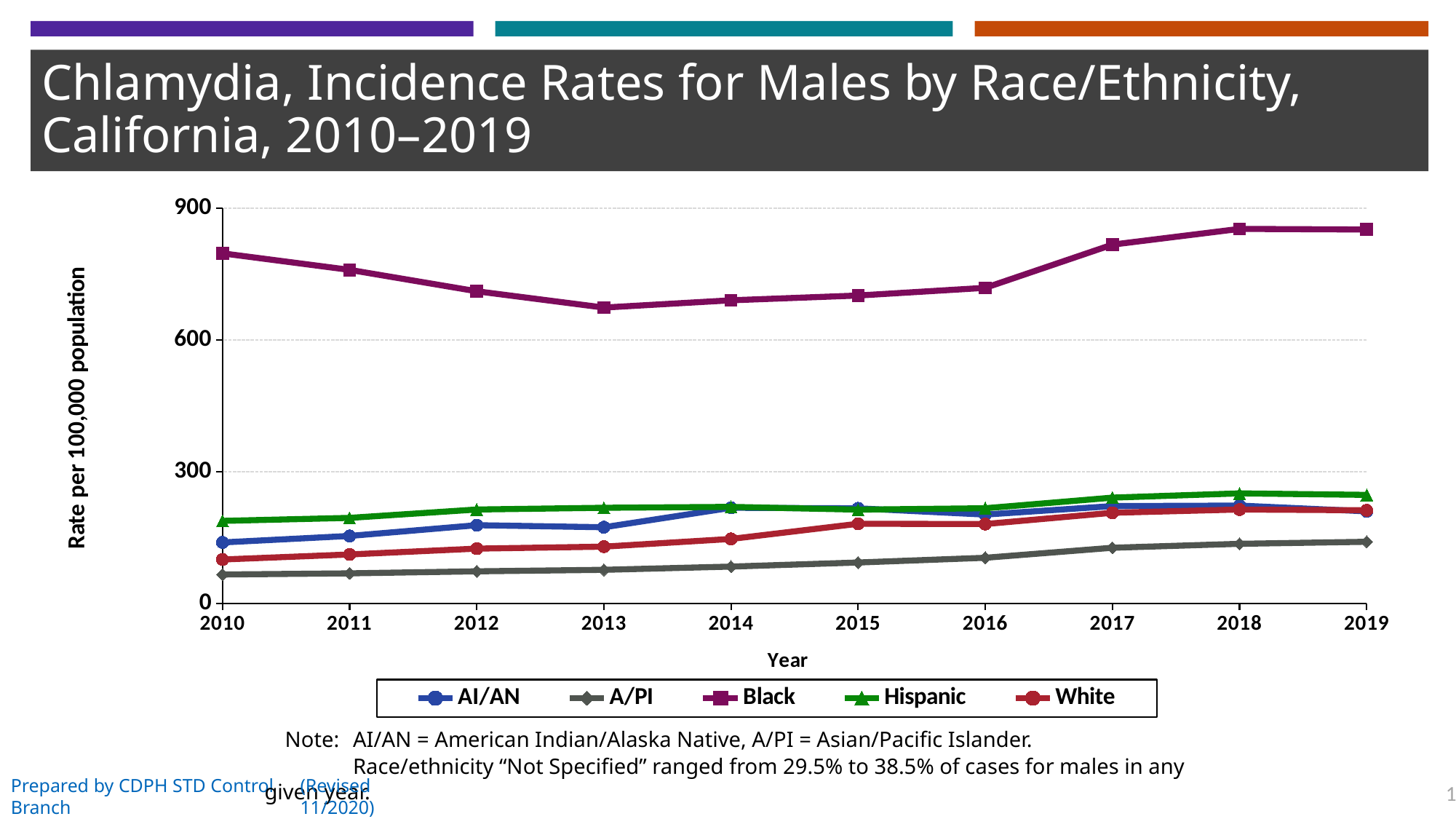
Is the rate for A/PI males in 2010 greater or less than 300? less Is the rate for Black males in 2010 greater or less than 600? greater Which is larger in 2019: the rate for Hispanic males or the rate for A/PI males? Hispanic What kind of chart is shown on the slide? line chart How many series does the legend list? 5 Does the rate for A/PI males rise or fall from 2010 to 2019? rise How many years are plotted along the x axis? 10 Which race/ethnicity group has the lowest chlamydia incidence rate for males in every year shown? A/PI Which is larger: the rate for Black males in 2019 or the rate for Black males in 2013? 2019 What is the label of the y axis? Rate per 100,000 population Which race/ethnicity group has the highest chlamydia incidence rate for males in every year shown? Black Is the rate for Hispanic males in 2019 greater or less than 300? less